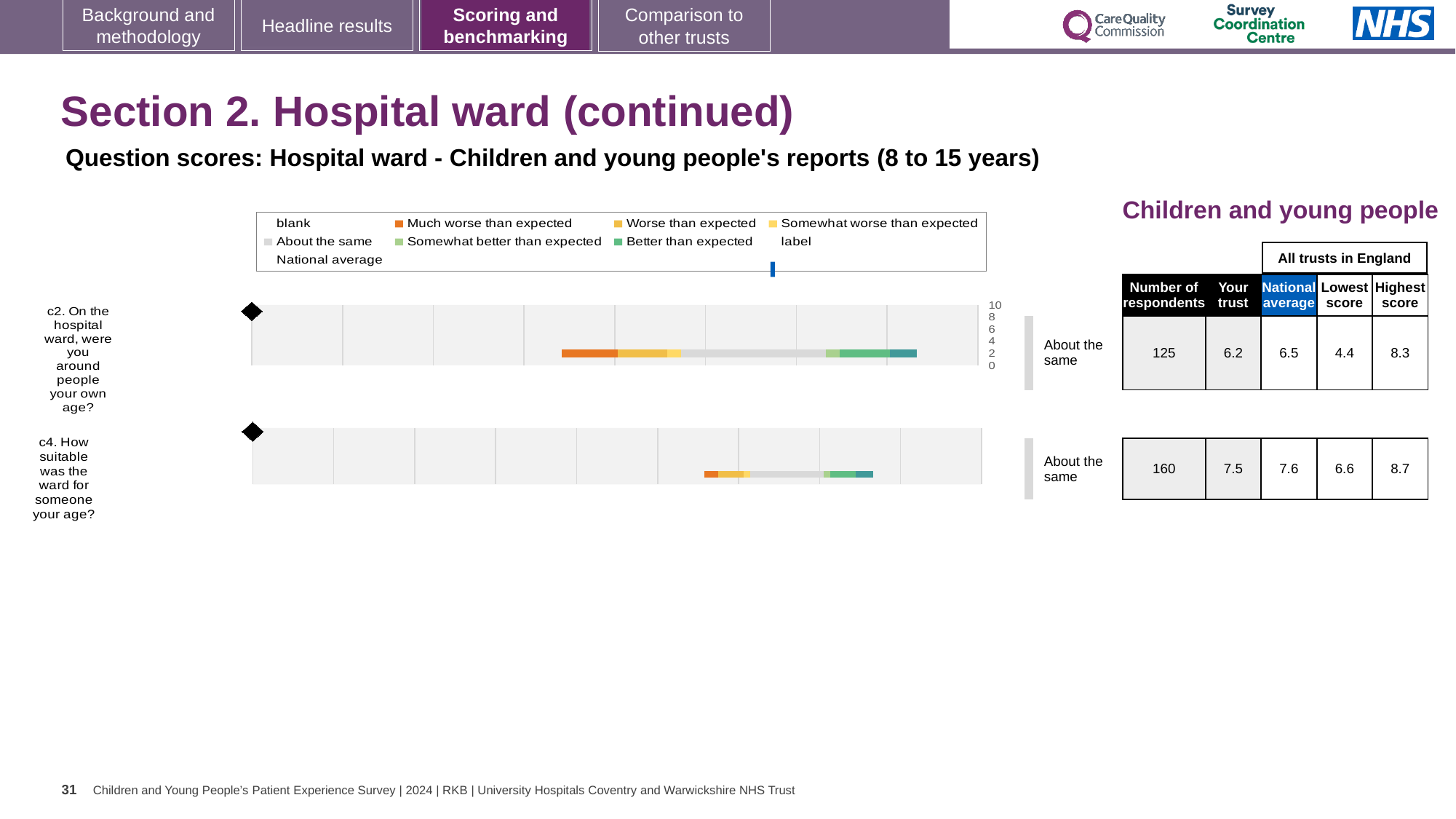
What is the lowest score across all trusts in England for question c2? 4.4 What is the highest score across all trusts in England for question c4? 8.7 What is the difference between the highest and lowest scores for question c4? 2.1 What is the number of respondents for question c2 (On the hospital ward, were you around people your own age?)? 125 What is the difference between the highest and lowest scores for question c2? 3.9 How many questions (c2 and c4) are plotted on the slide? 2 For question c2, is the 'Your trust' score higher or lower than the national average? lower What is the 'Your trust' score for question c4 (How suitable was the ward for someone your age?)? 7.5 What is the national average score for question c2? 6.5 What kind of chart is used to show the question scores for c2 and c4? bar chart What benchmark category is shown next to both question c2 and question c4? About the same Which question has the higher 'Your trust' score, c2 or c4? c4